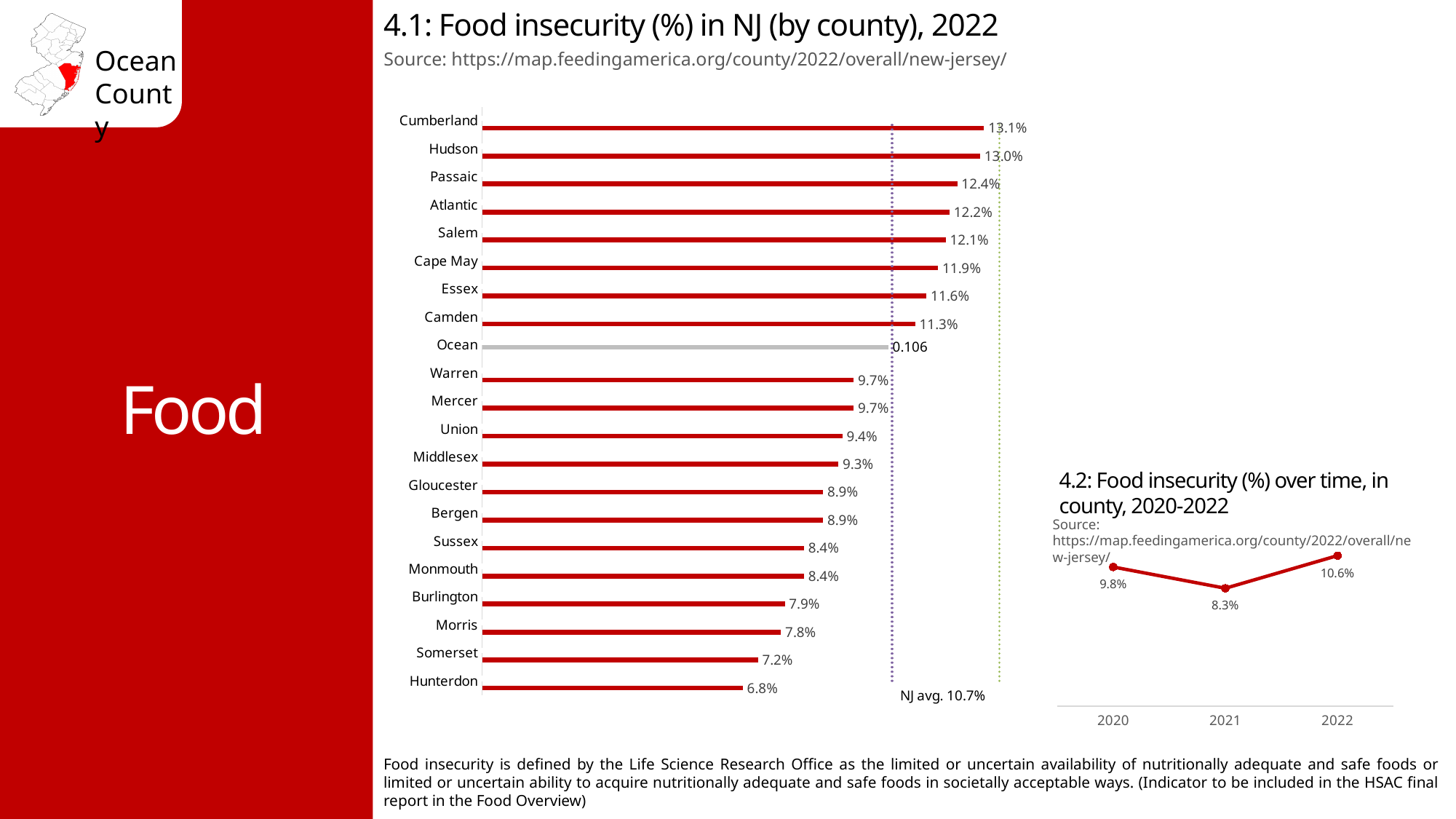
In chart 4.2 (Food insecurity over time, 2020-2022), what was the food insecurity rate in 2021? 8.3% In chart 4.1 (Food insecurity in NJ by county, 2022), which county has the lowest food insecurity rate? Hunterdon In chart 4.1 (Food insecurity in NJ by county, 2022), how many counties are shown? 21 In chart 4.1 (Food insecurity in NJ by county, 2022), what is the difference between Cumberland's rate and Hunterdon's rate? 6.3 percentage points In chart 4.1 (Food insecurity in NJ by county, 2022), what is the food insecurity rate for Cumberland? 13.1% In chart 4.1 (Food insecurity in NJ by county, 2022), which has a higher food insecurity rate, Essex or Camden? Essex What kind of chart is chart 4.1 (Food insecurity in NJ by county, 2022)? Bar chart In chart 4.1 (Food insecurity in NJ by county, 2022), what NJ average value is labelled on the chart? 10.7% In chart 4.2 (Food insecurity over time, 2020-2022), which year had the lowest food insecurity rate? 2021 In chart 4.1 (Food insecurity in NJ by county, 2022), which county has the highest food insecurity rate? Cumberland What kind of chart is chart 4.2 (Food insecurity over time, 2020-2022)? Line chart In chart 4.1 (Food insecurity in NJ by county, 2022), what is the food insecurity rate for Camden? 11.3%